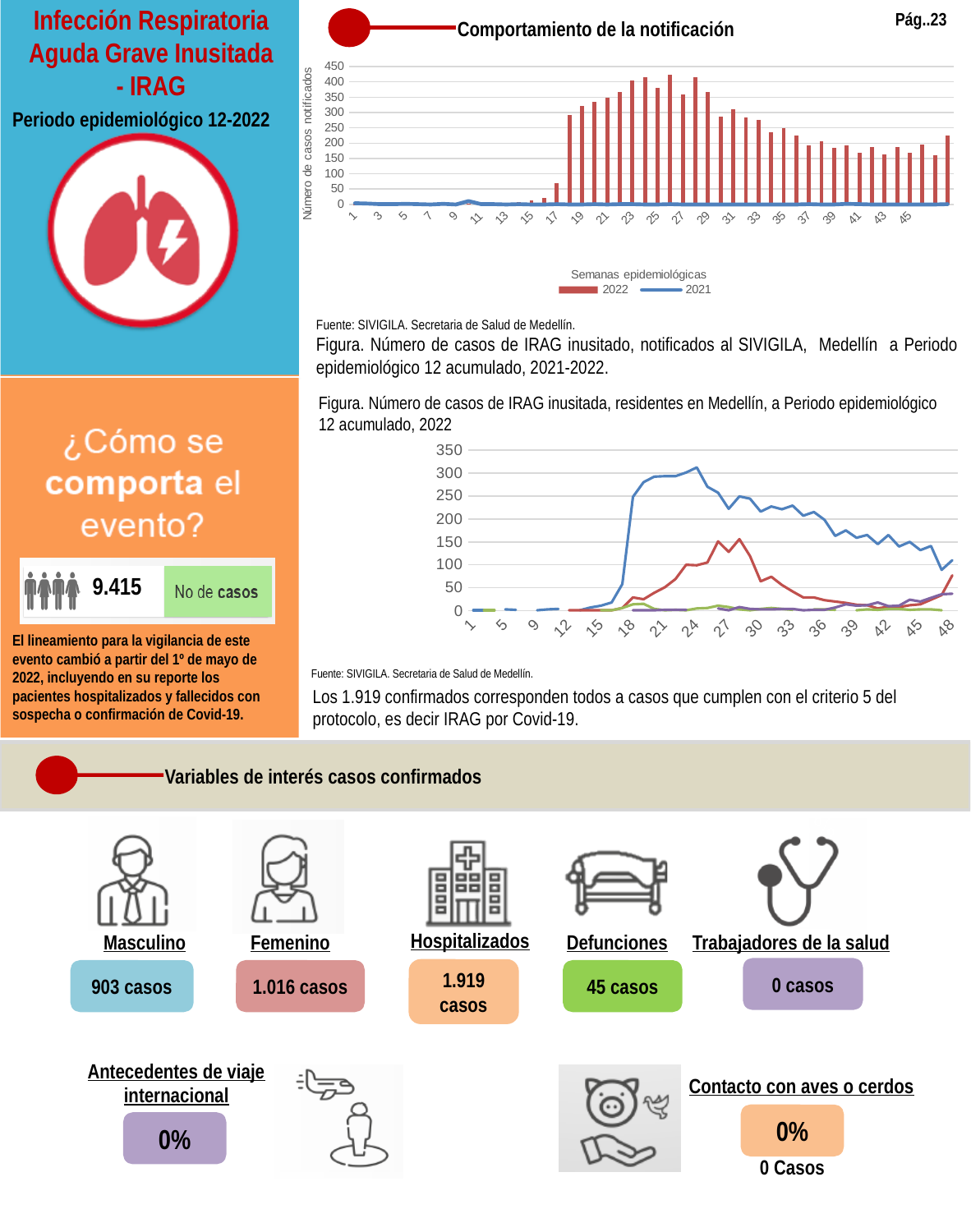
In the top chart 'Comportamiento de la notificación', is the 2022 value for week 45 greater or less than 200? less In the top chart 'Comportamiento de la notificación', do the 2022 bars rise or fall from week 27 to week 35? fall In the top chart 'Comportamiento de la notificación', what kind of chart is used for the 2022 series? bar chart In the bottom chart showing IRAG inusitada cases of residents in Medellín, is the peak of the red line greater or less than 100? greater In the bottom chart showing IRAG inusitada cases of residents in Medellín, is the peak of the blue line greater or less than 300? greater In the top chart 'Comportamiento de la notificación', which series is drawn as red bars? 2022 How many series does the legend of the top chart 'Comportamiento de la notificación' list? 2 In the top chart 'Comportamiento de la notificación', which series has the higher value at week 25, 2022 or 2021? 2022 What kind of chart is the bottom chart showing IRAG inusitada cases of residents in Medellín, 2022? line chart